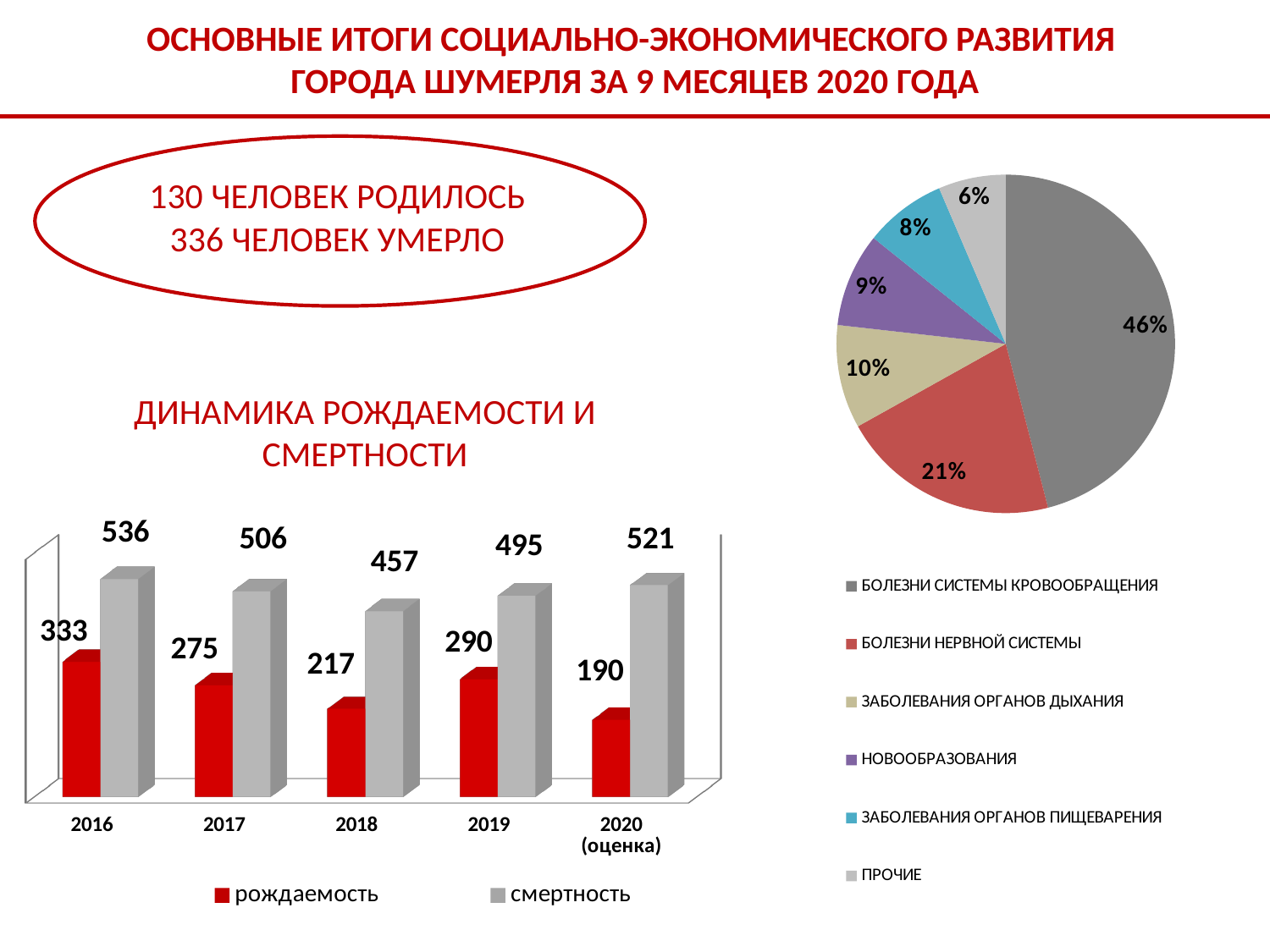
What kind of chart is the chart on the left of the slide, titled 'ДИНАМИКА РОЖДАЕМОСТИ И СМЕРТНОСТИ'? bar chart In the bar chart 'ДИНАМИКА РОЖДАЕМОСТИ И СМЕРТНОСТИ', what is the difference between смертность and рождаемость in 2019? 205 In the bar chart 'ДИНАМИКА РОЖДАЕМОСТИ И СМЕРТНОСТИ', which year has the highest смертность value? 2016 In the bar chart 'ДИНАМИКА РОЖДАЕМОСТИ И СМЕРТНОСТИ', how many years are shown on the x axis? 5 In the pie chart on the right of the slide, what share does БОЛЕЗНИ СИСТЕМЫ КРОВООБРАЩЕНИЯ have? 46% In the pie chart on the right of the slide, which category has the smallest share? ПРОЧИЕ In the bar chart 'ДИНАМИКА РОЖДАЕМОСТИ И СМЕРТНОСТИ', which is larger: рождаемость in 2017 or рождаемость in 2019? 2019 In the bar chart 'ДИНАМИКА РОЖДАЕМОСТИ И СМЕРТНОСТИ', what is the value of рождаемость for 2016? 333 In the bar chart 'ДИНАМИКА РОЖДАЕМОСТИ И СМЕРТНОСТИ', how many series does the legend list? 2 In the bar chart 'ДИНАМИКА РОЖДАЕМОСТИ И СМЕРТНОСТИ', which year has the lowest рождаемость value? 2020 (оценка) In the pie chart on the right of the slide, how many categories does the legend list? 6 In the bar chart 'ДИНАМИКА РОЖДАЕМОСТИ И СМЕРТНОСТИ', what is the value of смертность for 2018? 457